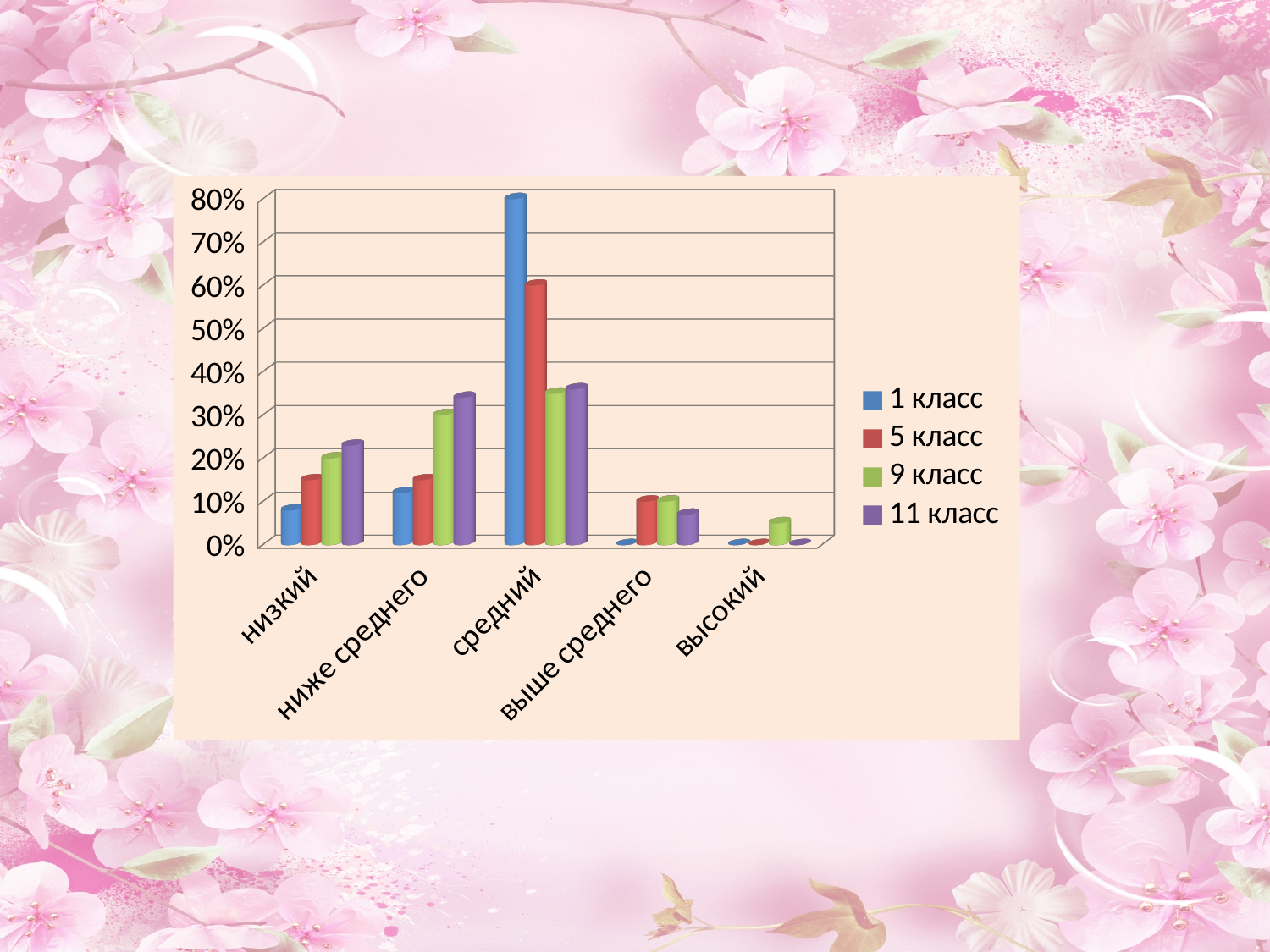
In the низкий category, which is larger: the value for 1 класс or the value for 11 класс? 11 класс How many series does the legend list? 4 For which category is the value for 1 класс highest? средний Is the value for 11 класс in the низкий category greater or less than 30%? less What kind of chart is shown on the slide? bar chart Is the value for 9 класс in the ниже среднего category greater or less than 20%? greater Is the value for 1 класс in the средний category greater or less than 70%? greater Which series is shown in blue in the legend? 1 класс How many categories are shown along the x axis? 5 In the средний category, which is larger: the value for 1 класс or the value for 5 класс? 1 класс